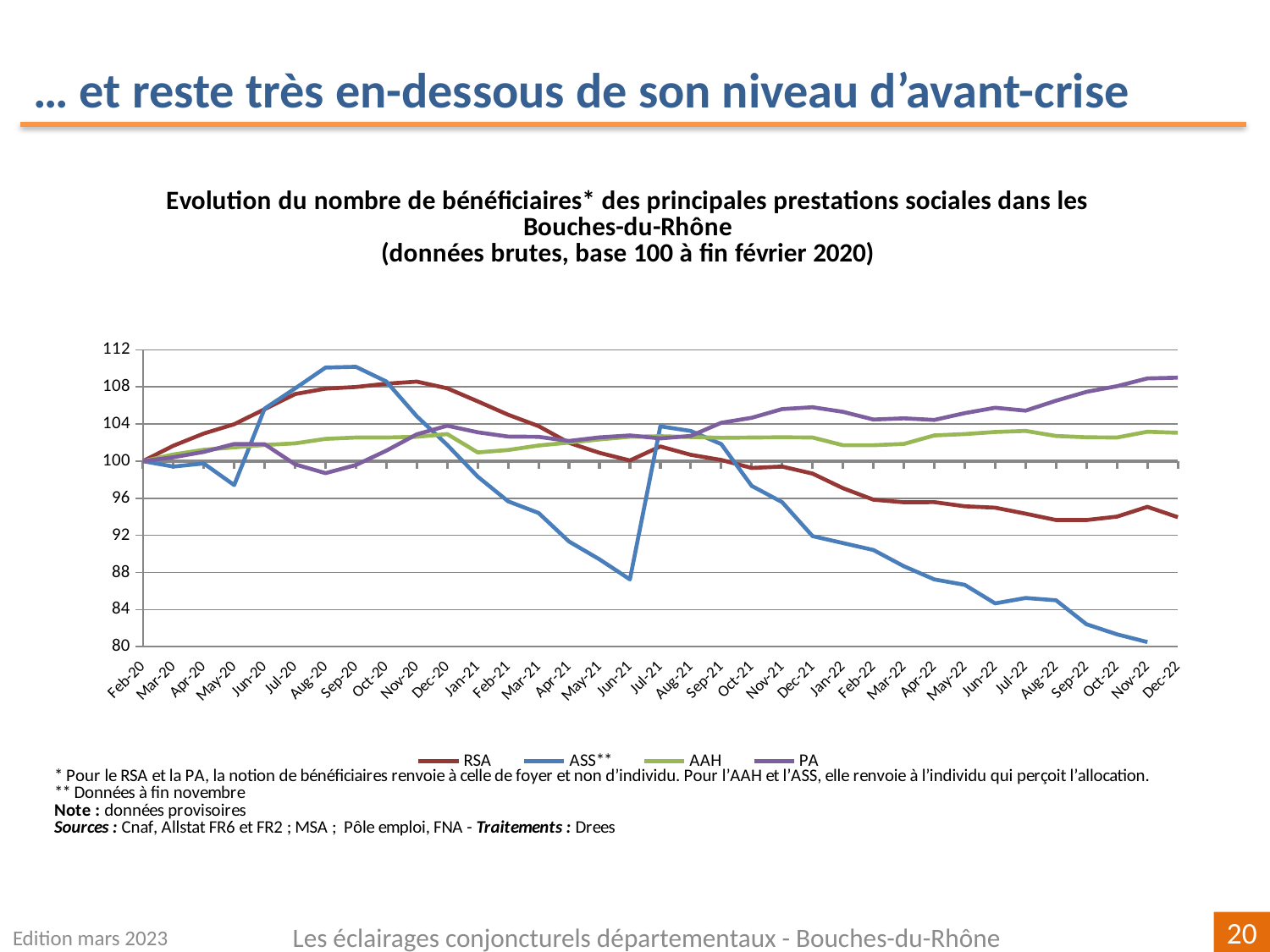
Is the value for ASS** in Sep-20 greater or less than 108? greater Which colour is used for the PA series in the legend? purple Is the value for ASS** in Nov-22 greater or less than 84? less Is the value for PA in Dec-22 greater or less than 108? greater In Jun-21, which is larger, the value for AAH or the value for ASS**? AAH Which series has the highest value in Dec-22? PA How many series does the legend list? 4 Does the ASS** series rise or fall between Jul-21 and Nov-22? fall What kind of chart is shown on the slide? line chart Which series has the lowest value in Nov-22? ASS** How many monthly points are labelled on the x axis, from Feb-20 to Dec-22? 35